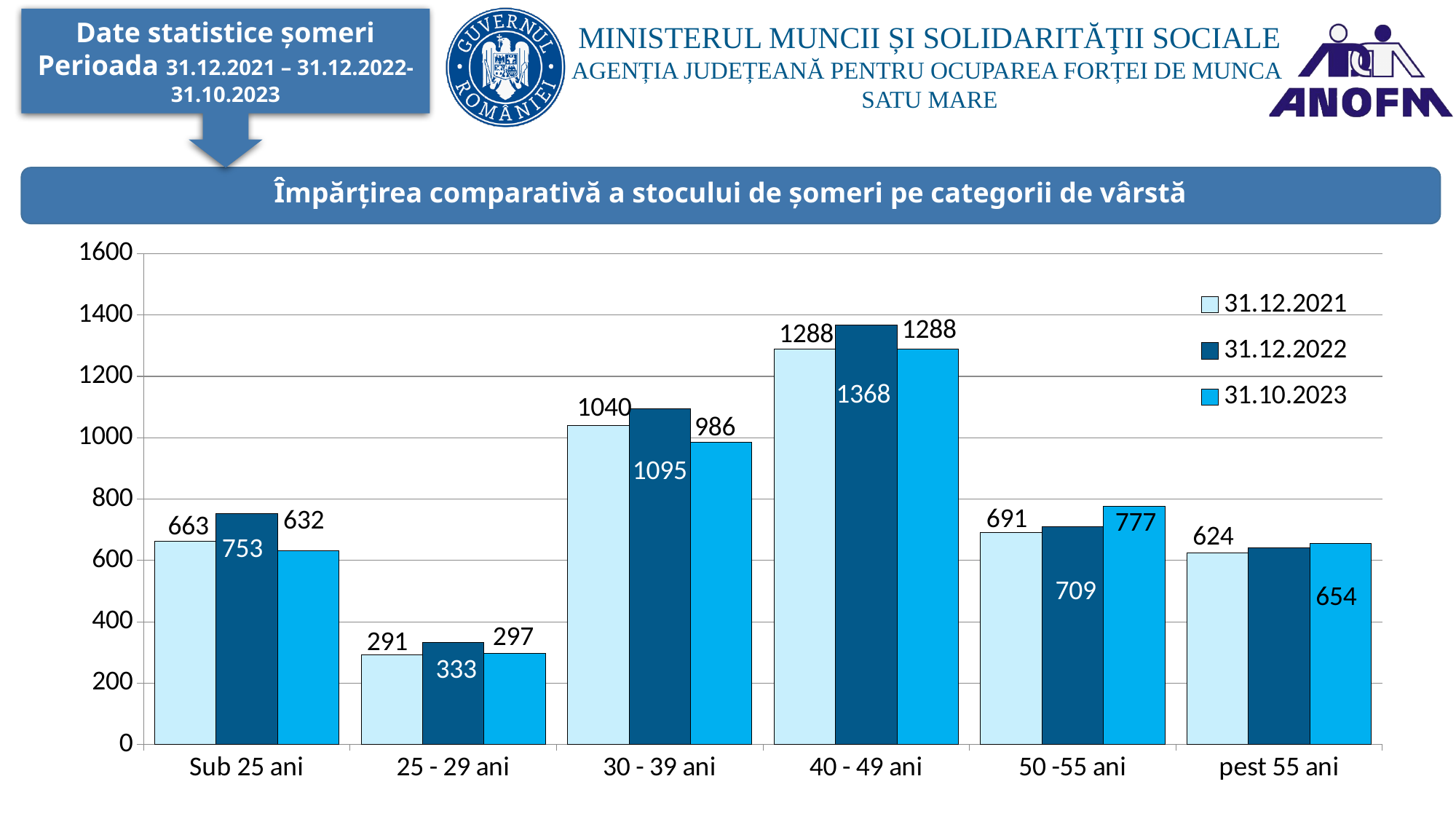
Which age category has the highest value in the 31.12.2021 series? 40 - 49 ani For the Sub 25 ani category, which series has the larger value: 31.12.2021 or 31.10.2023? 31.12.2021 How many age categories are shown on the x axis? 6 Is the value for the pest 55 ani category in the 31.12.2022 series greater or less than 800? less For the 30 - 39 ani category, how much higher is the 31.12.2022 value than the 31.12.2021 value? 55 How many series does the legend list? 3 What is the value for the 25 - 29 ani category in the 31.12.2021 series? 291 What kind of chart is shown on the slide? bar chart Which age category has the lowest value in the 31.10.2023 series? 25 - 29 ani What is the value for the 30 - 39 ani category in the 31.10.2023 series? 986 For the 50 -55 ani category, what is the difference between the 31.10.2023 value and the 31.12.2021 value? 86 What is the value for the 40 - 49 ani category in the 31.12.2022 series? 1368